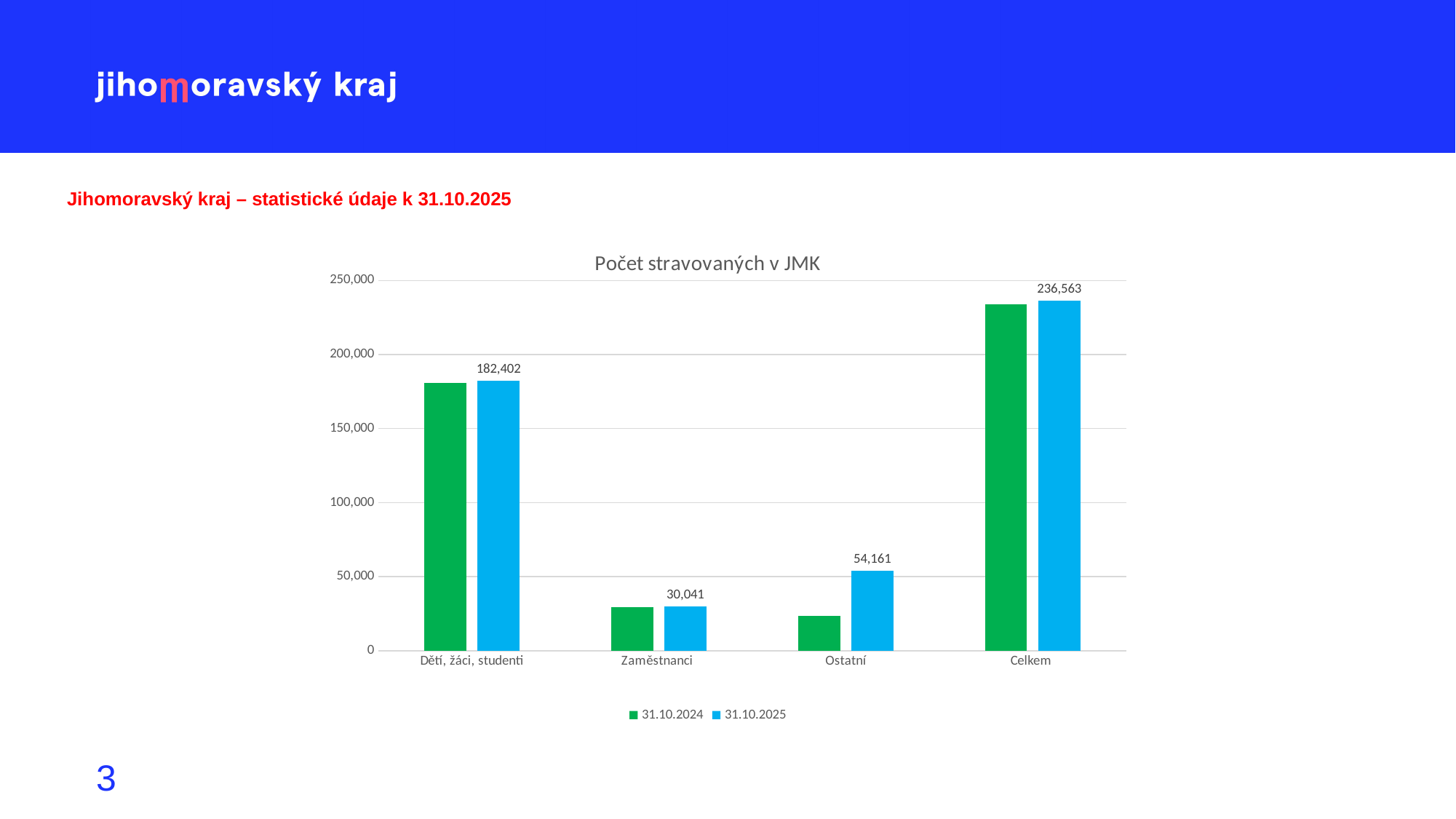
What is the value for Ostatní in the 31.10.2025 series? 54,161 For Ostatní, which series has the larger value, 31.10.2024 or 31.10.2025? 31.10.2025 Is the 31.10.2024 value for Děti, žáci, studenti greater or less than 150,000? greater What is the value for Celkem in the 31.10.2025 series? 236,563 How many series does the legend list? 2 Which category has the highest value in the 31.10.2025 series? Celkem What kind of chart is shown on the slide? bar chart What is the value for Zaměstnanci in the 31.10.2025 series? 30,041 Which category has the lowest value in the 31.10.2025 series? Zaměstnanci What is the difference between the 31.10.2025 values for Ostatní and Zaměstnanci? 24,120 What is the value for Děti, žáci, studenti in the 31.10.2025 series? 182,402 How many categories are shown on the x axis? 4